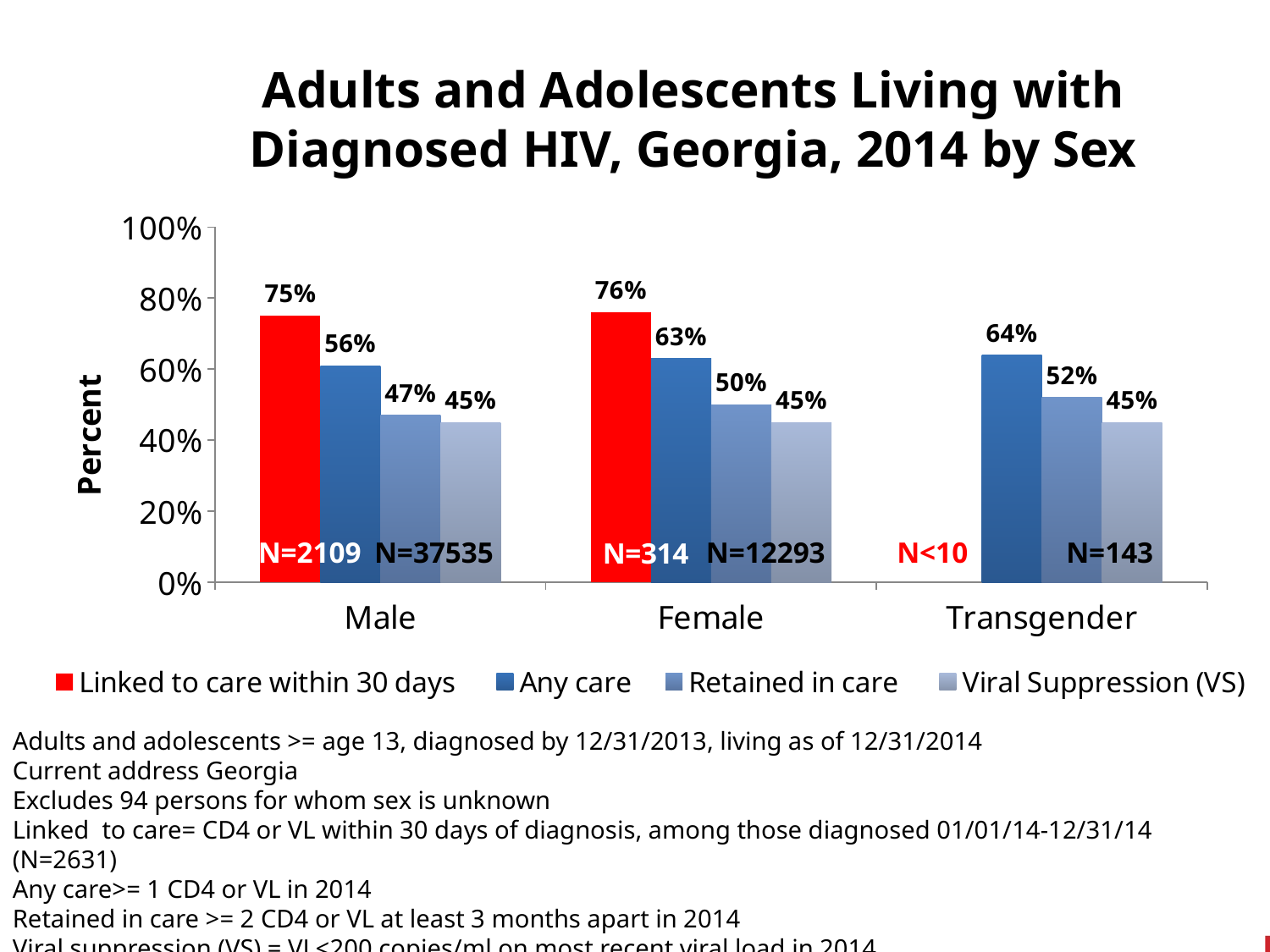
What is the value for Any care for Male? 56% What is the value for Any care for Transgender? 64% What is the difference between the Any care values for Female and Male? 7% What kind of chart is shown on the slide? Bar chart Which series is shown in red? Linked to care within 30 days What is the value for Retained in care for Female? 50% Which is larger, Retained in care for Transgender or Retained in care for Female? Retained in care for Transgender Which category has the highest value for Any care? Transgender Which category has the lowest value for Retained in care? Male What is the value for Linked to care within 30 days for Female? 76% How many categories are shown on the x axis? 3 How many series does the legend list? 4